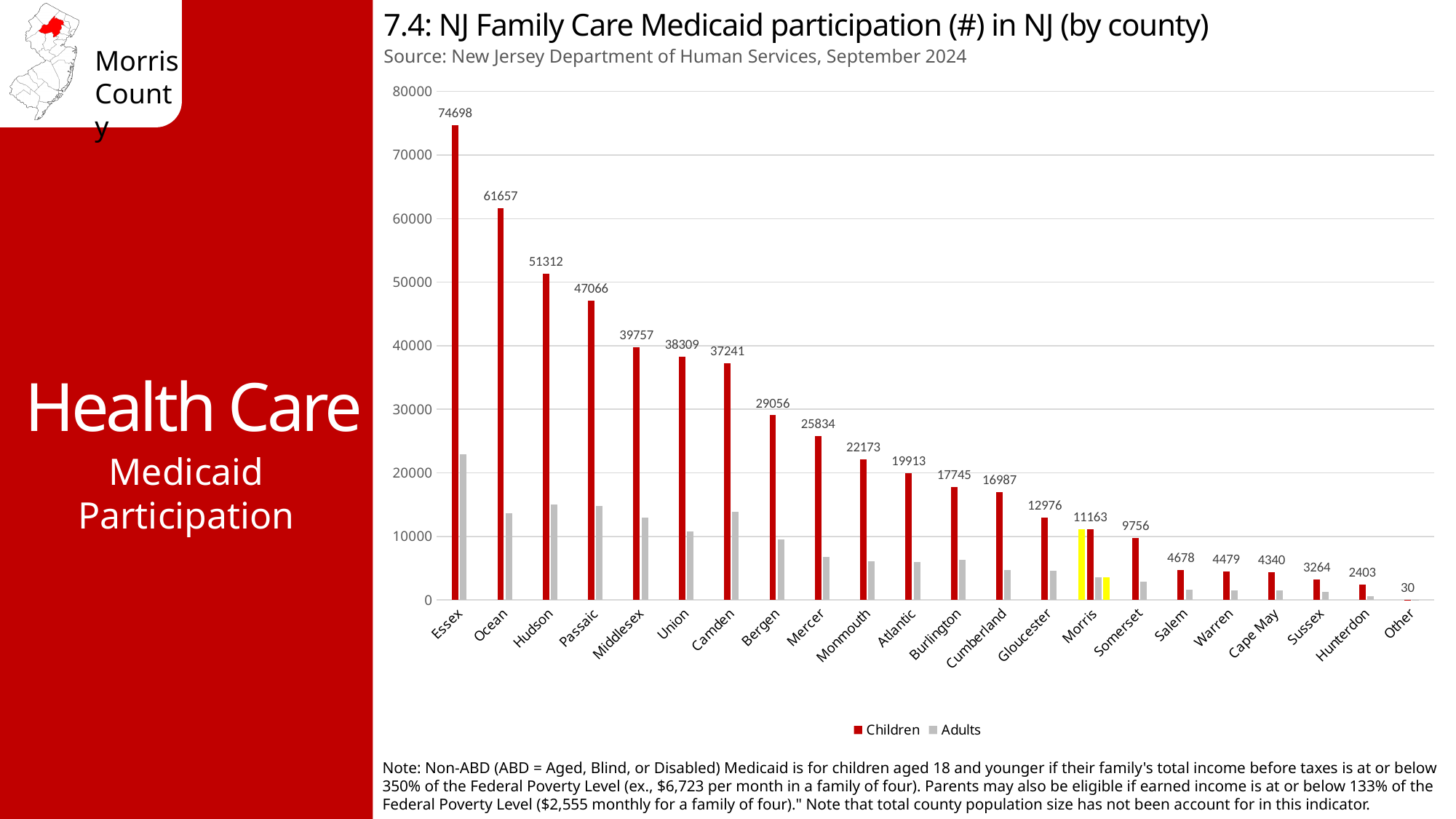
How many categories are shown on the x axis? 22 What is the difference between the Children values for Essex and Ocean? 13041 Which county has the highest Children value? Essex Which has a larger Children value, Hudson or Passaic? Hudson Is the Adults value for Essex greater or less than 20000? greater What kind of chart is shown? bar chart What is the difference between the Children values for Morris and Somerset? 1407 How many series does the legend list? 2 What is the Children value for Essex? 74698 What is the Children value for Morris? 11163 Do the Children values rise or fall from left to right along the x axis? fall Which category has the lowest Children value? Other